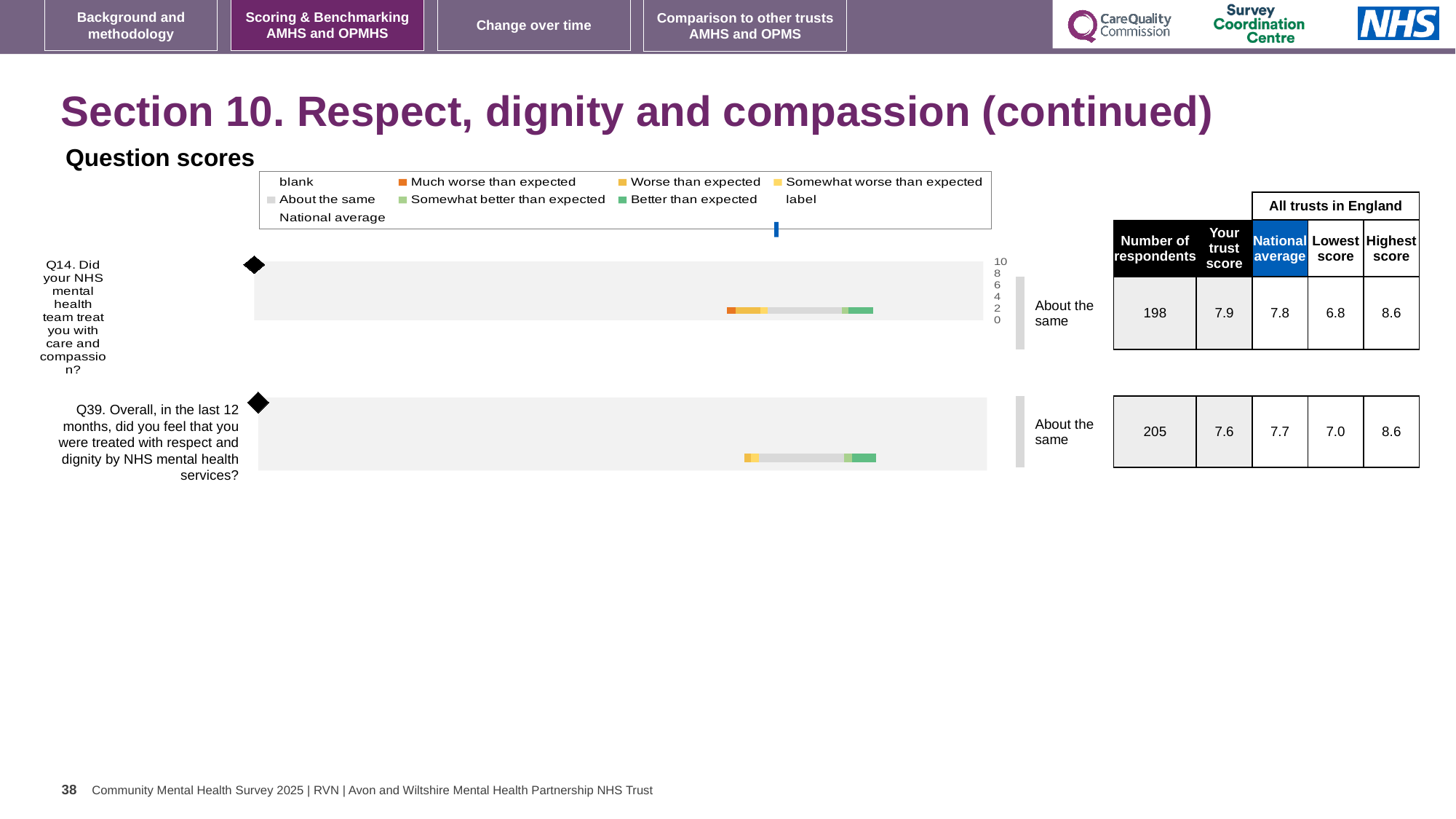
What is the trust score for Q14 (care and compassion)? 7.9 What benchmark category is shown next to the bar for Q14? About the same What kind of chart is used to show the question scores on this slide? bar chart What is the trust score for Q39 (respect and dignity)? 7.6 Which legend entry is shown in orange in the question scores chart? Much worse than expected What is the difference between the trust score for Q14 and the trust score for Q39? 0.3 Which question has the higher trust score, Q14 or Q39? Q14 What is the national average score for Q14? 7.8 How many questions are plotted in the question scores chart? 2 What is the lowest score among all trusts in England for Q39? 7.0 How many respondents answered Q39? 205 What is the highest score among all trusts in England for Q14? 8.6